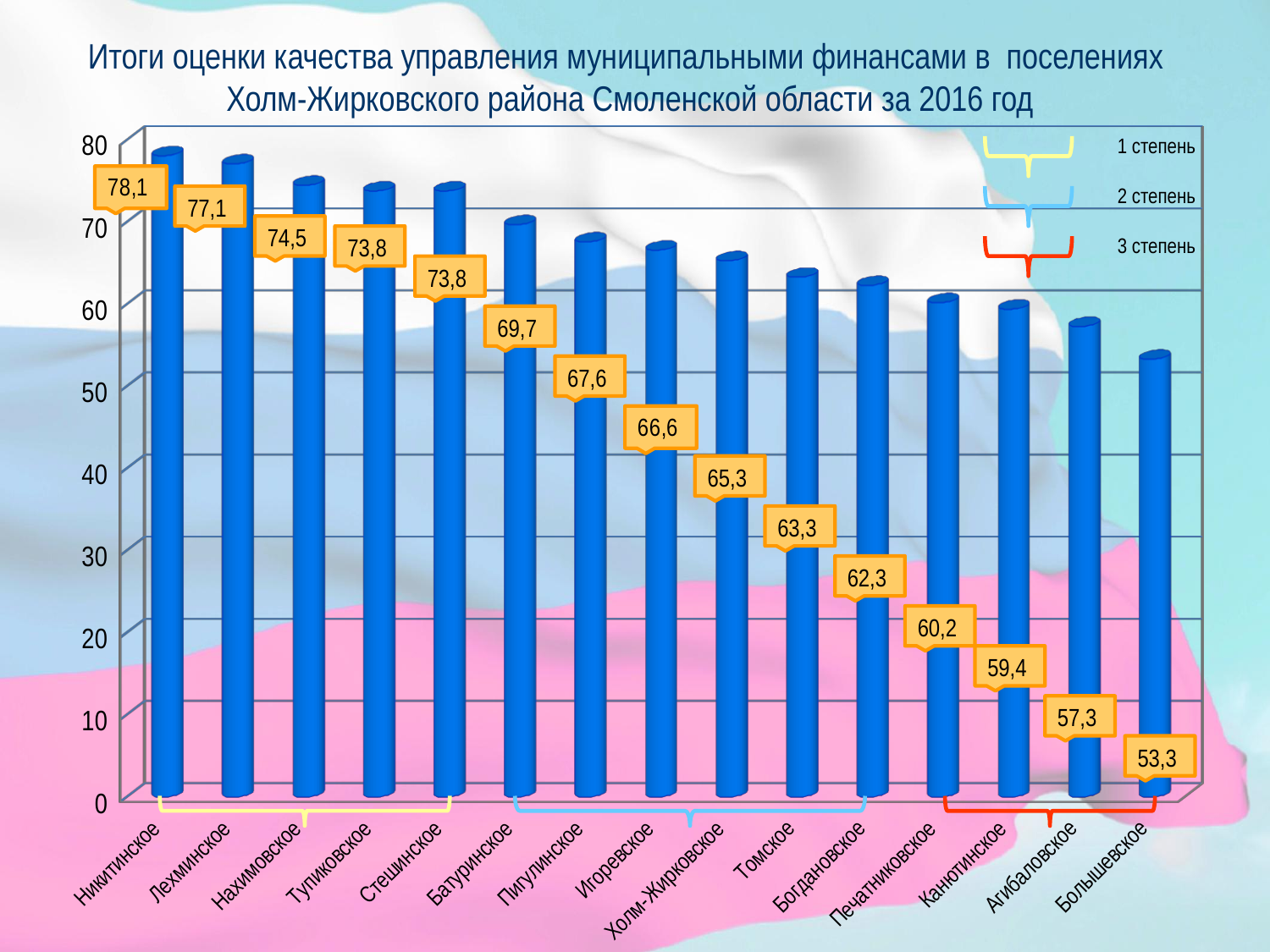
How many settlements are shown on the chart? 15 What is the difference between the values for Никитинское and Большевское? 24,8 Which settlement has the lowest value? Большевское Which is larger, the value for Томское or the value for Печатниковское? Томское How many groups (степень) does the legend list? 3 What is the value for Батуринское? 69,7 What is the value for Канютинское? 59,4 Which settlement has the highest value? Никитинское Do the values rise or fall from left to right along the x axis? Fall What is the value for Никитинское? 78,1 What kind of chart is shown on the slide? Bar chart What is the difference between the values for Батуринское and Пигулинское? 2,1